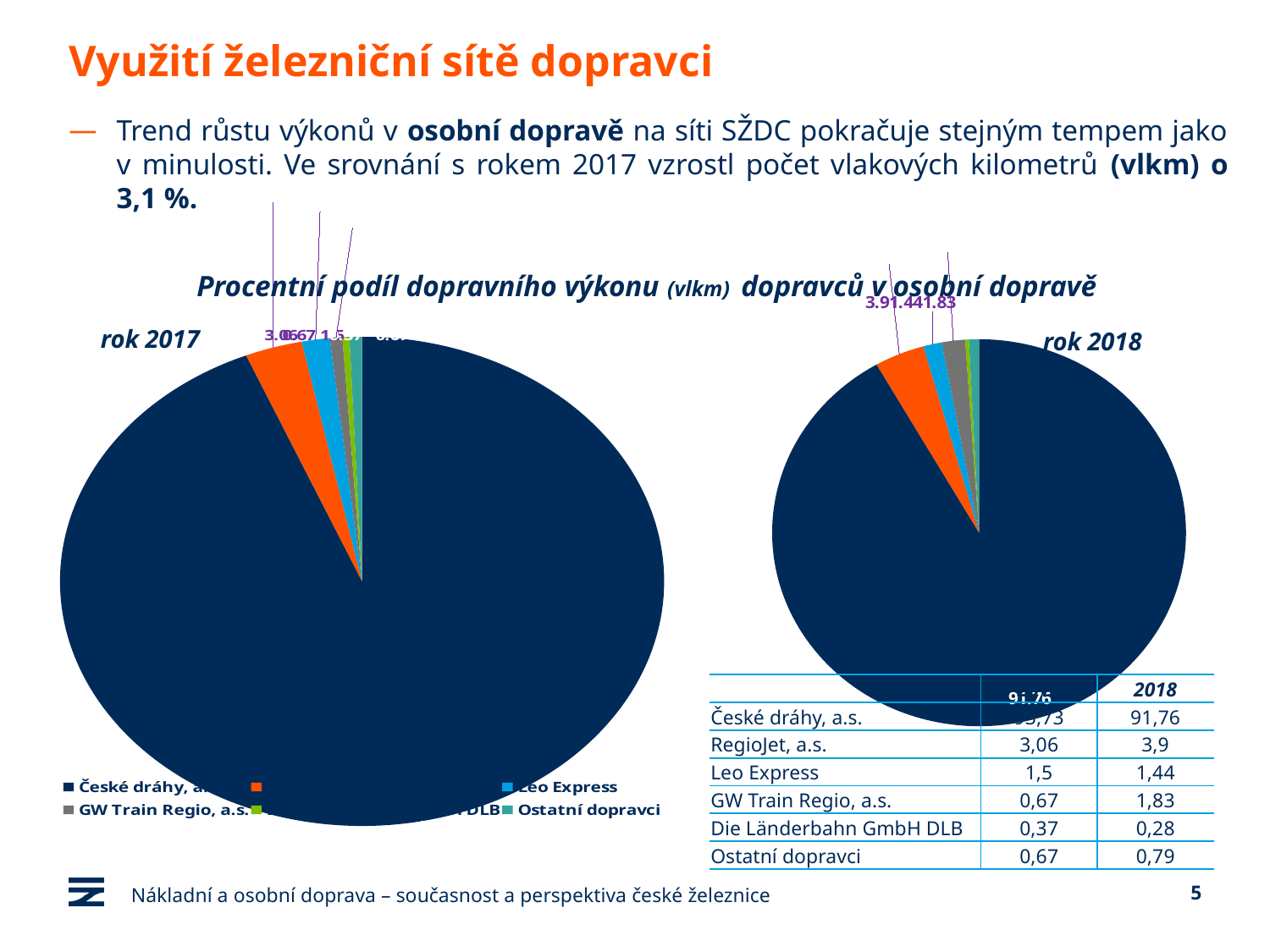
In the rok 2018 pie chart, which carrier has the largest slice? České dráhy, a.s. What is the title shown above the two pie charts? Procentní podíl dopravního výkonu (vlkm) dopravců v osobní dopravě According to the table, which carrier has the smallest share in 2018? Die Länderbahn GmbH DLB Is the share of GW Train Regio, a.s. larger in 2017 or in 2018? 2018 By how much did the share of RegioJet, a.s. increase from 2017 to 2018 according to the table? 0,84 Is the share of Leo Express larger in 2017 or in 2018? 2017 According to the table, what is the percentage share of České dráhy, a.s. in 2018? 91,76 According to the table, what is the share of Die Länderbahn GmbH DLB in 2018? 0,28 By how much did the share of České dráhy, a.s. decrease from 2017 to 2018 according to the table? 1,97 According to the table, what is the percentage share of RegioJet, a.s. in 2017? 3,06 How many carriers (categories) are shown in the rok 2018 pie chart legend and table? 6 What kind of chart is used to show the share of transport performance for rok 2017 and rok 2018? pie chart